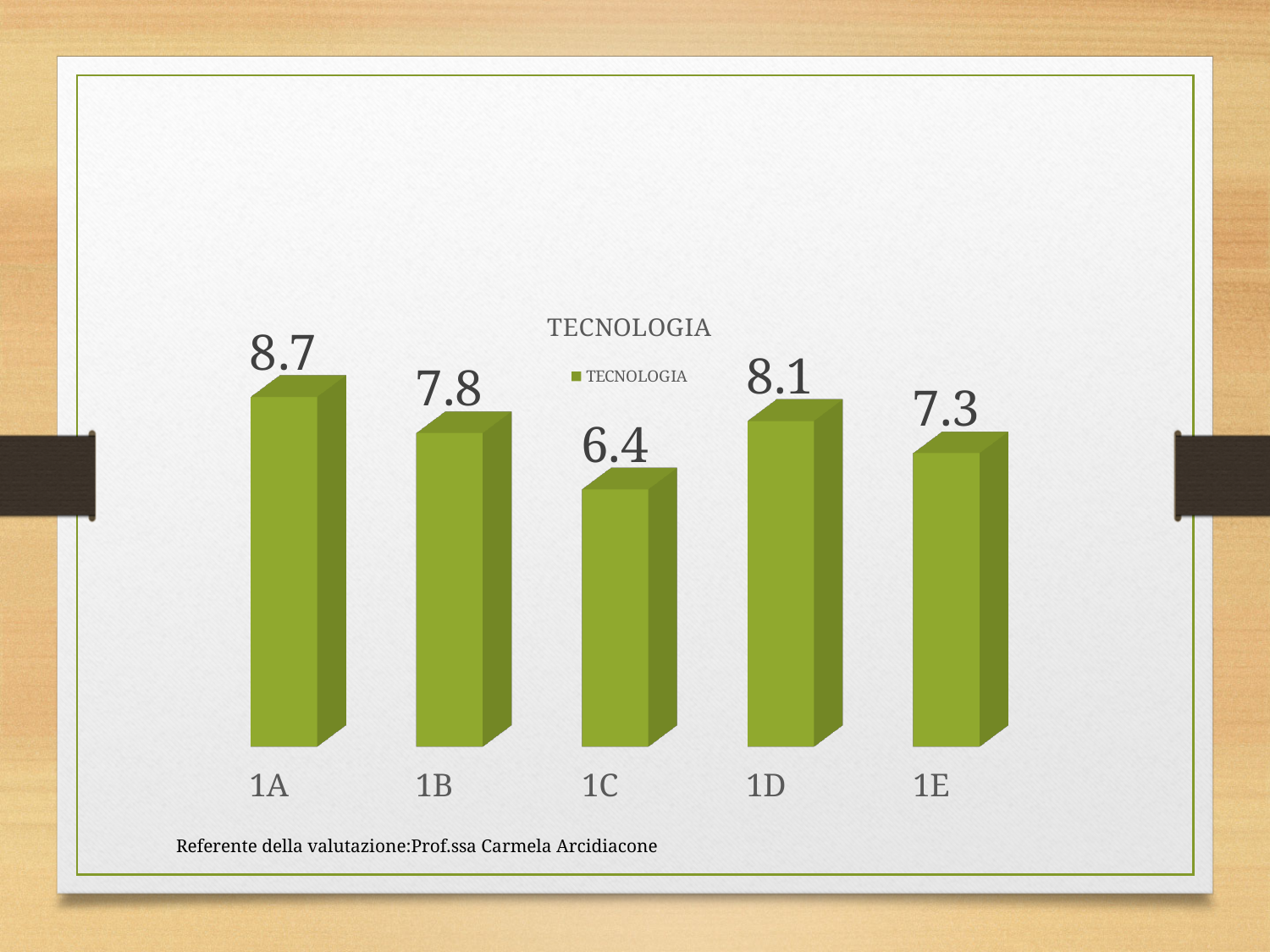
Which category has the lowest value? 1C Which is larger, the value for 1B or the value for 1E? 1B What is the value for 1E? 7.3 What is the value for 1C? 6.4 What is the title of the chart? TECNOLOGIA Which category has the highest value? 1A What is the difference between the values for 1A and 1C? 2.3 How many categories are shown in the chart? 5 What is the value for 1A? 8.7 How many series does the legend list? 1 What is the difference between the values for 1D and 1B? 0.3 What kind of chart is shown? bar chart